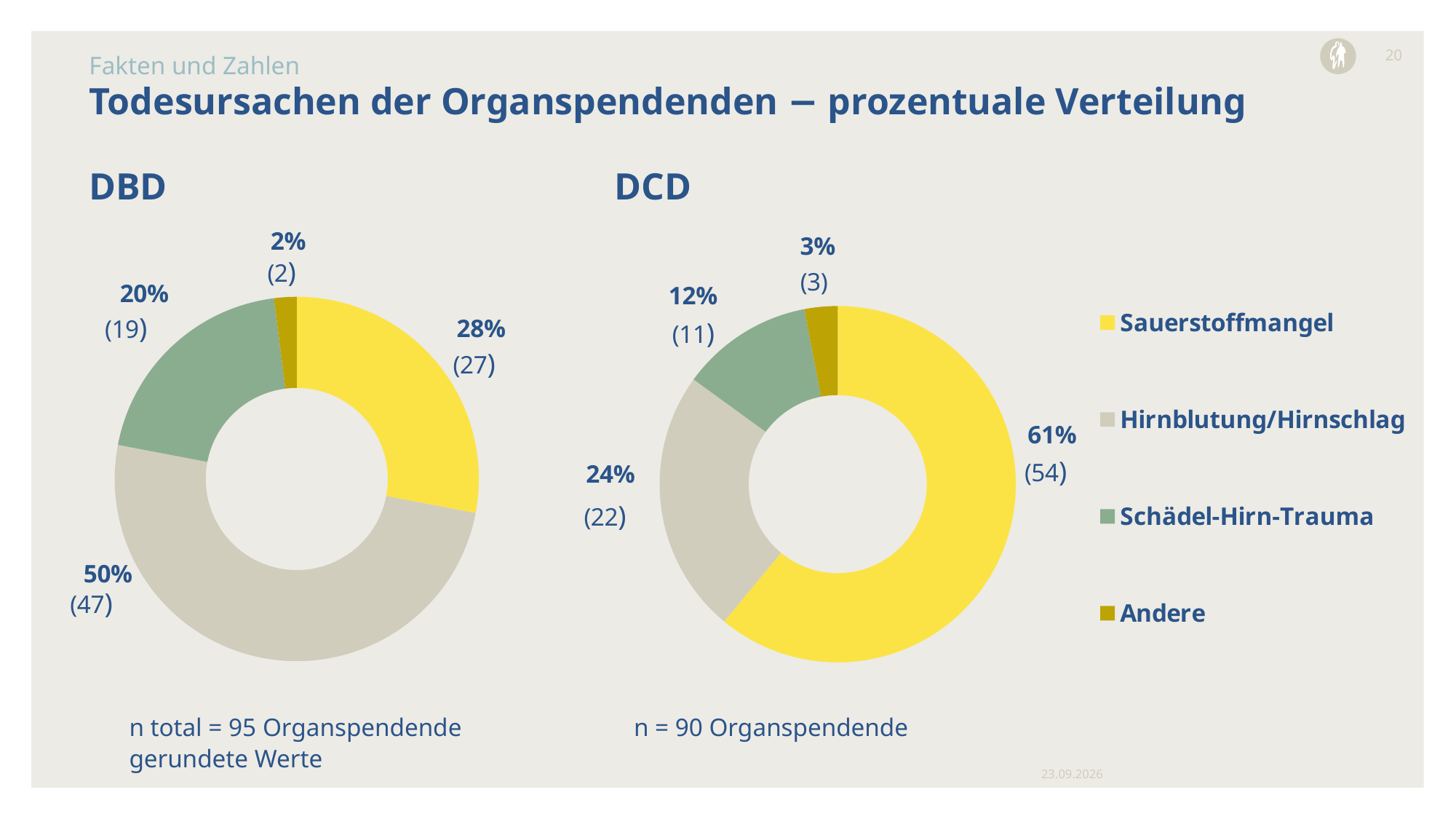
In the DBD chart, which is larger: the share for Sauerstoffmangel or the share for Schädel-Hirn-Trauma? Sauerstoffmangel How many categories does each pie chart show? 4 What colour represents Hirnblutung/Hirnschlag in the legend? Light grey What is the difference in percentage points between Sauerstoffmangel in the DCD chart and Sauerstoffmangel in the DBD chart? 33 In the DCD chart, what percentage is shown for Sauerstoffmangel? 61% What is the total number of organ donors (n) stated for the DCD chart? 90 In the DBD chart, how many donors are shown in parentheses for Schädel-Hirn-Trauma? 19 In the DBD chart, what percentage is shown for Hirnblutung/Hirnschlag? 50% What type of chart is used for DBD and DCD? Pie chart (donut) In the DBD chart, which category has the largest share? Hirnblutung/Hirnschlag In the DCD chart, which category has the smallest share? Andere In the DCD chart, how many donors are shown in parentheses for Andere? 3